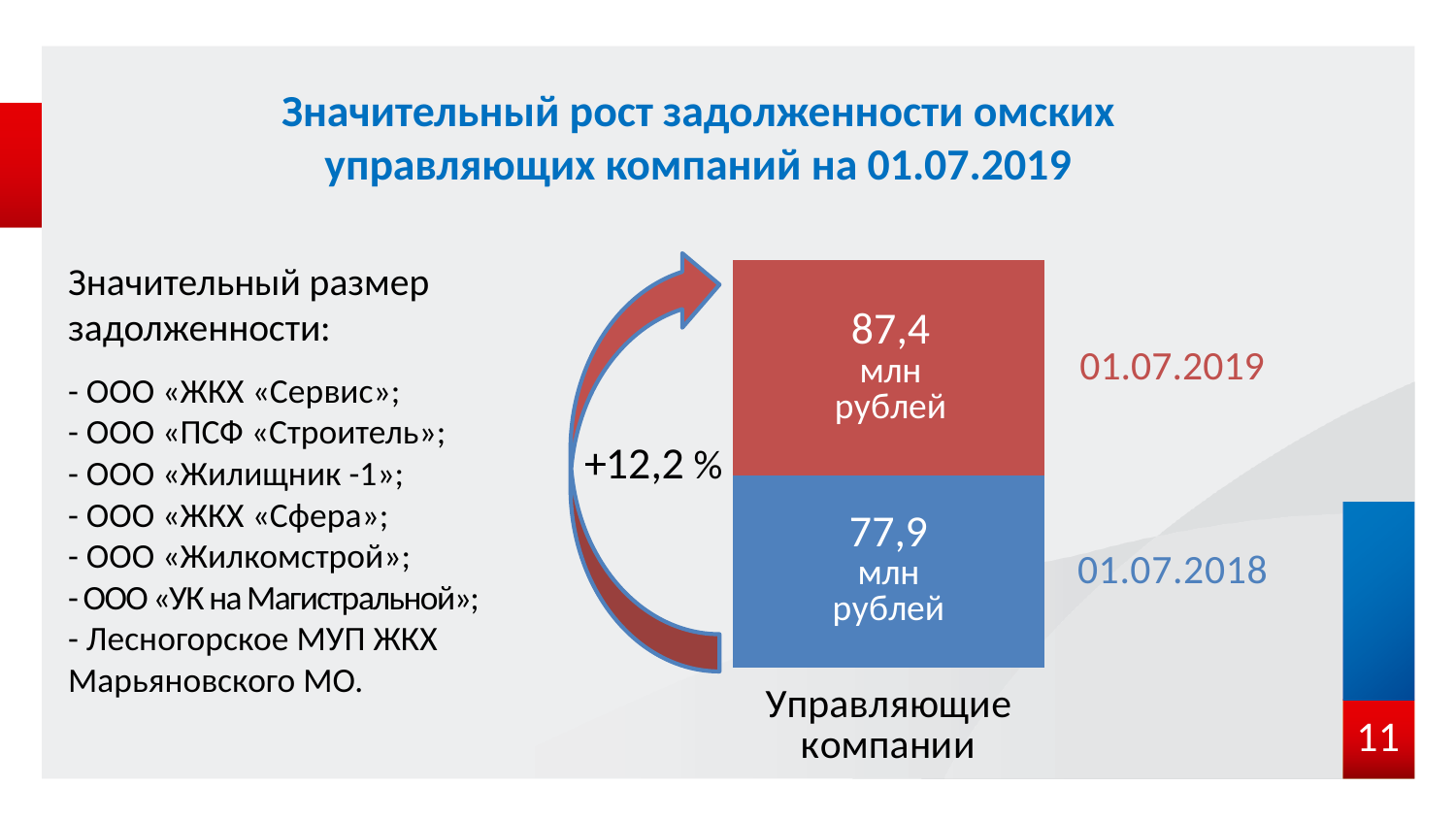
By how much (in млн рублей) does the value for 01.07.2019 exceed the value for 01.07.2018? 9,5 млн рублей What is the debt value shown for 01.07.2019? 87,4 млн рублей Which date has the higher debt value, 01.07.2019 or 01.07.2018? 01.07.2019 How many segments (dates) does the bar contain? 2 Which date has the lowest debt value on the chart? 01.07.2018 What is the combined total of the two segments of the stacked bar? 165,3 млн рублей What is the debt value shown for 01.07.2018? 77,9 млн рублей Did the debt of the management companies rise or fall from 01.07.2018 to 01.07.2019? Rise What percentage growth is shown on the arrow next to the chart? +12,2 % What is the category label under the bar? Управляющие компании What kind of chart is shown on the slide? Stacked bar chart Which colour represents 01.07.2019 on the chart? Red